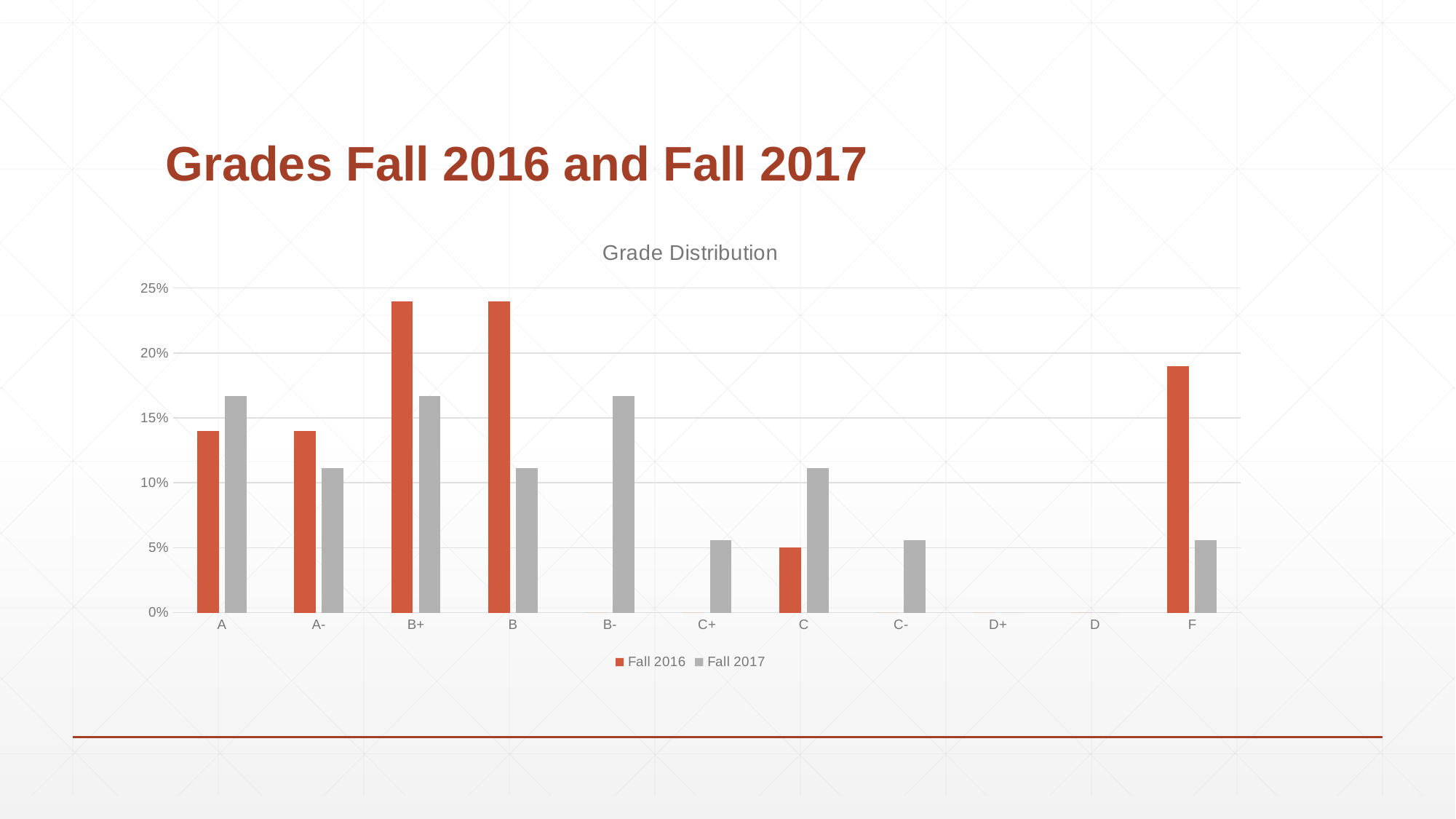
What kind of chart is shown on the slide? bar chart Which series is shown in grey? Fall 2017 Is the Fall 2016 value for B+ greater or less than 20%? greater For grade F, which series has the larger value, Fall 2016 or Fall 2017? Fall 2016 Is the Fall 2017 value for C- greater or less than 10%? less What is the title of the chart? Grade Distribution For grade B-, which series has the larger value, Fall 2016 or Fall 2017? Fall 2017 How many grade categories are shown on the x axis? 11 Is the Fall 2016 value for F greater or less than 15%? greater How many series does the legend list? 2